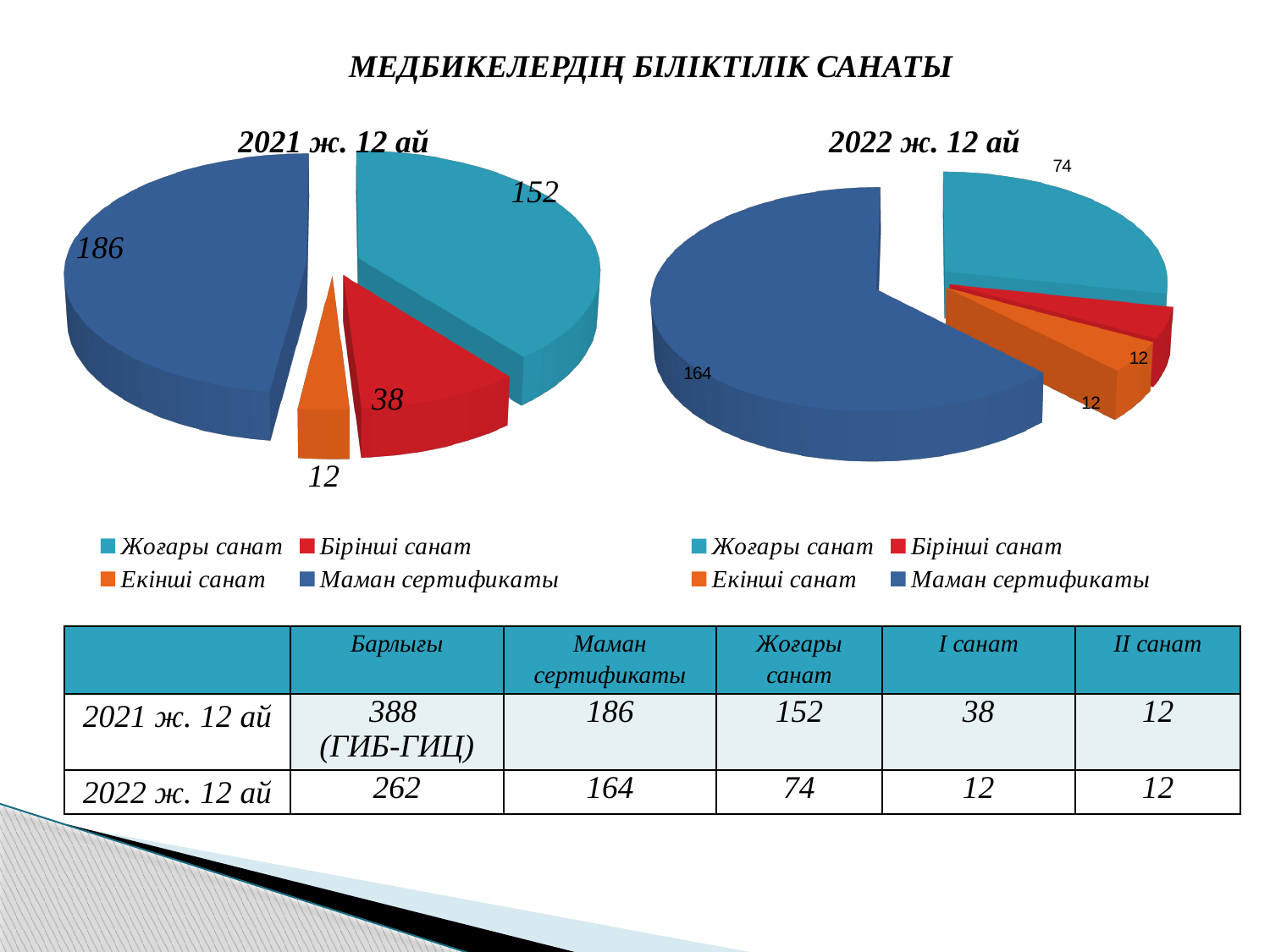
In the "2022 ж. 12 ай" pie chart, what is the value for Жоғары санат? 74 In the "2021 ж. 12 ай" pie chart, what is the difference between Маман сертификаты and Жоғары санат? 34 In the "2021 ж. 12 ай" pie chart, what is the value for Маман сертификаты? 186 What kind of chart is the "2021 ж. 12 ай" chart? Pie chart In the "2022 ж. 12 ай" pie chart, which category has the largest slice? Маман сертификаты Is the value for Жоғары санат larger in the "2021 ж. 12 ай" chart or the "2022 ж. 12 ай" chart? 2021 ж. 12 ай In the "2021 ж. 12 ай" pie chart, what is the value for Бірінші санат? 38 In the "2022 ж. 12 ай" pie chart, what is the difference between Маман сертификаты and Жоғары санат? 90 How many slices does the "2022 ж. 12 ай" pie chart have? 4 How many entries does the legend of the "2021 ж. 12 ай" chart list? 4 In the "2021 ж. 12 ай" pie chart, what colour is the Екінші санат slice? Orange In the "2021 ж. 12 ай" pie chart, which category has the smallest slice? Екінші санат